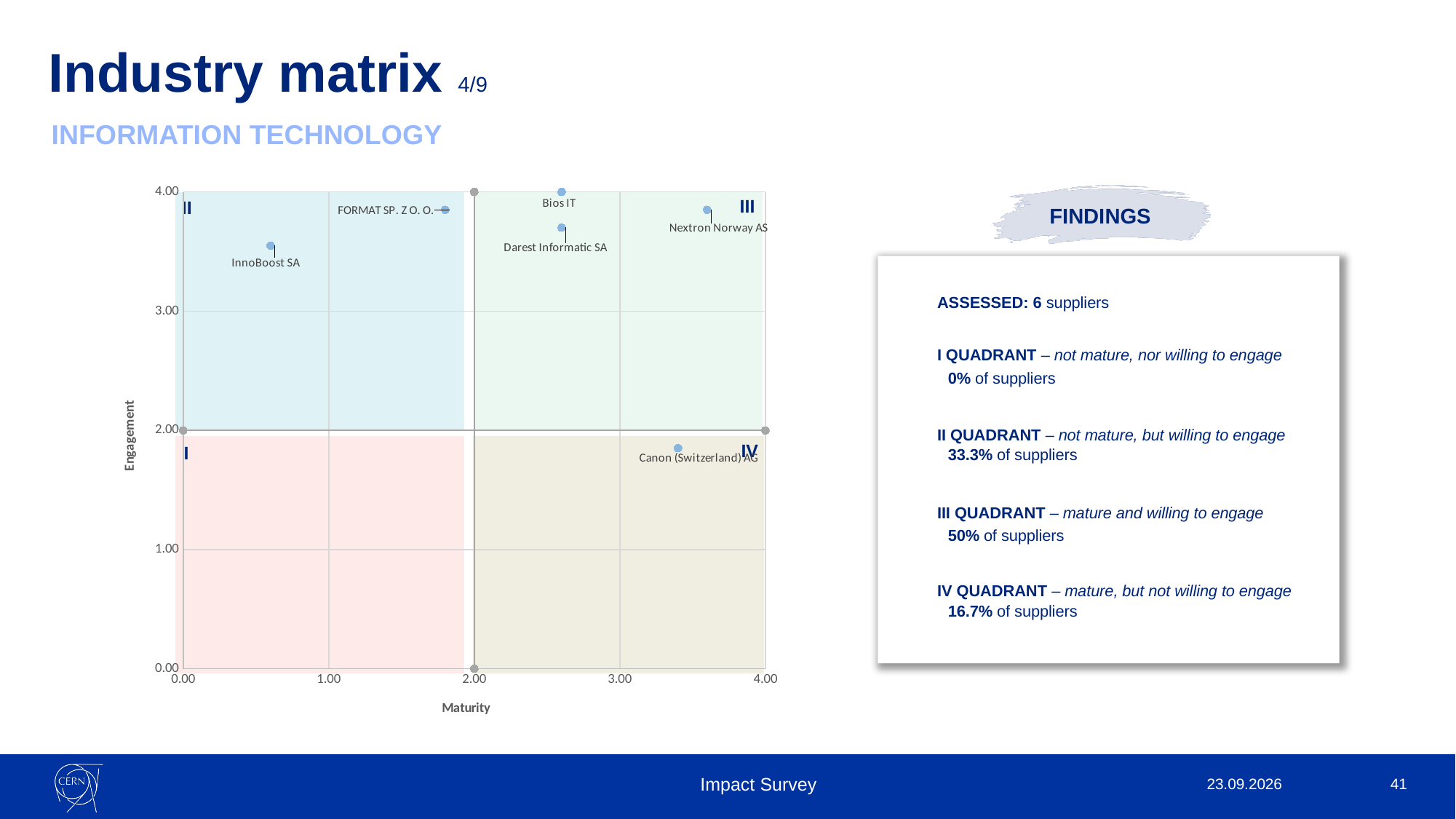
Is the Maturity value for Nextron Norway AS greater or less than 3.00? greater Which supplier has the higher Maturity value, InnoBoost SA or Nextron Norway AS? Nextron Norway AS What is the label of the vertical axis of the chart? Engagement Is the Engagement value for Darest Informatic SA greater or less than 3.00? greater What kind of chart is shown on the slide? Scatter chart Is the Engagement value for Canon (Switzerland) AG greater or less than 2.00? less Which supplier has the lowest Maturity value on the chart? InnoBoost SA Which supplier has the higher Engagement value, Canon (Switzerland) AG or Nextron Norway AS? Nextron Norway AS What is the label of the horizontal axis of the chart? Maturity Which supplier has the lowest Engagement value on the chart? Canon (Switzerland) AG How many suppliers are plotted on the chart? 6